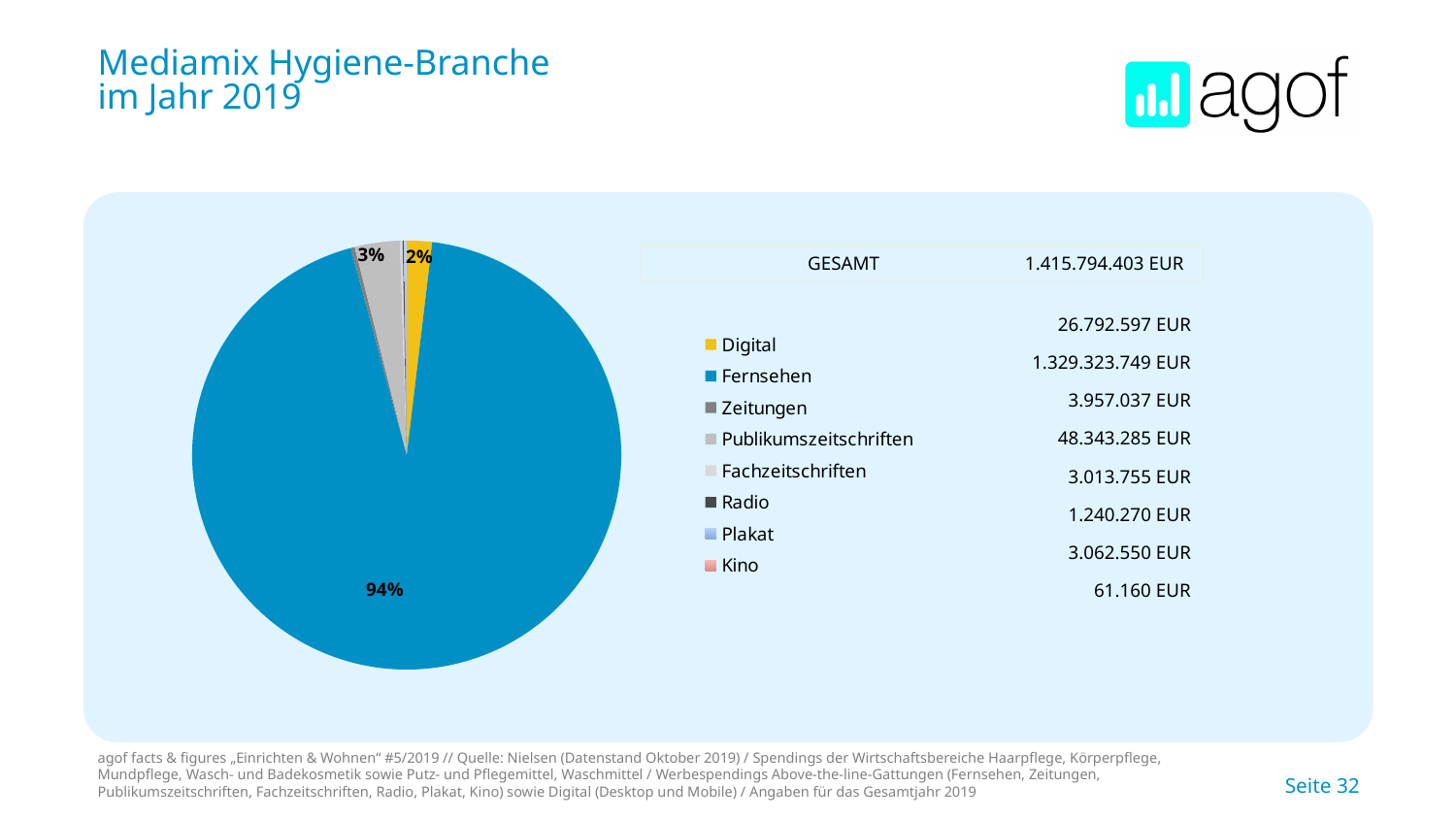
Which category has the largest value? Fernsehen What is the value shown for Kino? 61.160 EUR What share of the pie does Fernsehen account for? 94% What share of the pie does Publikumszeitschriften account for? 3% What share of the pie does Digital account for? 2% What is the value shown for Fernsehen? 1.329.323.749 EUR Which is larger, the value for Publikumszeitschriften or the value for Digital? Publikumszeitschriften How many categories does the legend of the pie chart list? 8 What is the GESAMT (total) value shown on the slide? 1.415.794.403 EUR Which category has the smallest value? Kino What is the value shown for Digital? 26.792.597 EUR What kind of chart is shown on the slide? pie chart